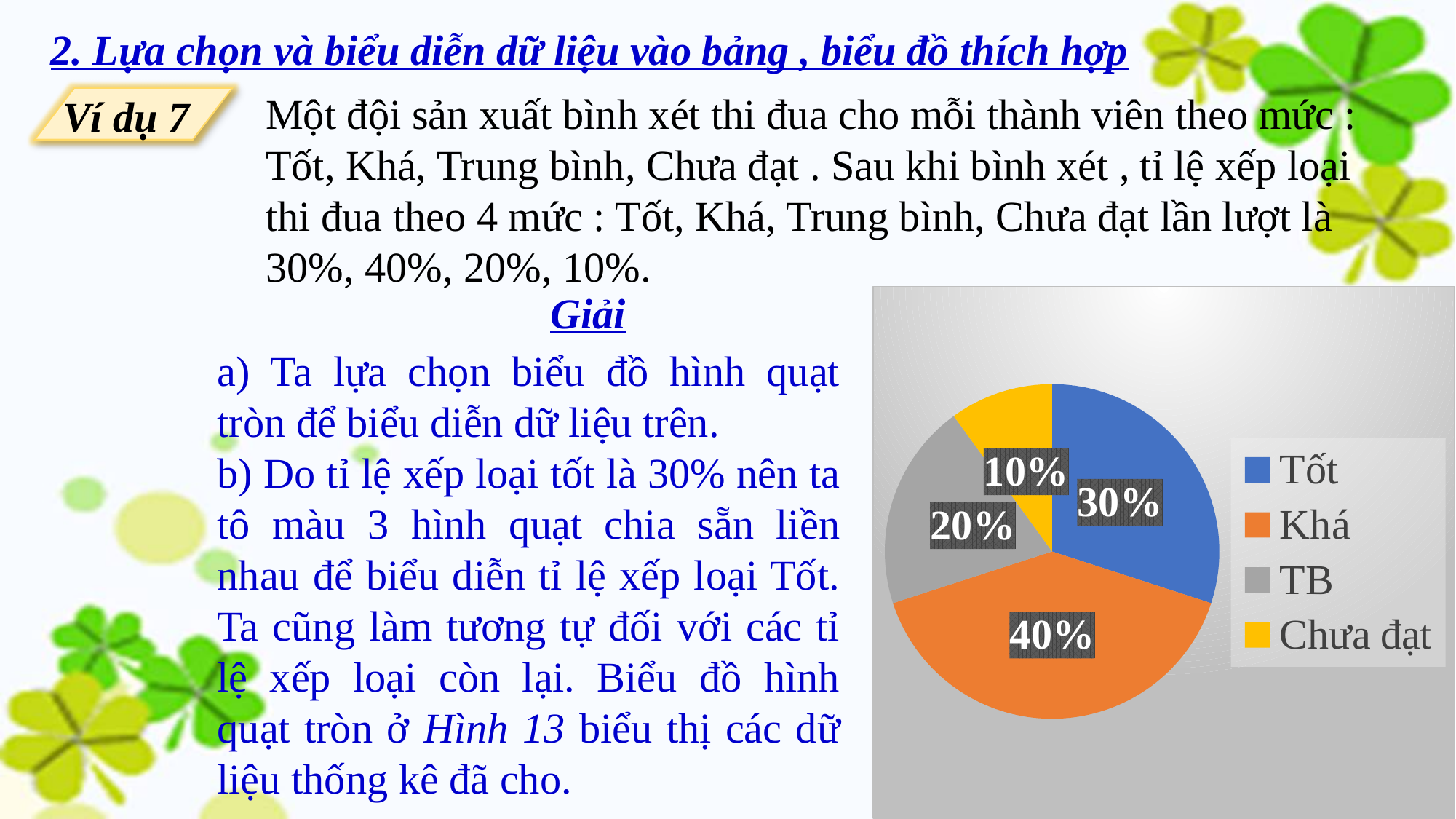
What percentage does the Khá slice show? 40% What colour is the Khá slice in the pie chart? orange How many entries does the legend list? 4 Which category has the smallest slice of the pie? Chưa đạt What percentage does the TB slice show? 20% What is the difference between the Khá and Tốt percentages? 10% What percentage does the Chưa đạt slice show? 10% How many slices does the pie chart have? 4 Which category has the largest slice of the pie? Khá Which is larger, the TB slice or the Chưa đạt slice? TB What percentage does the Tốt slice show? 30% What kind of chart is shown on the slide? pie chart